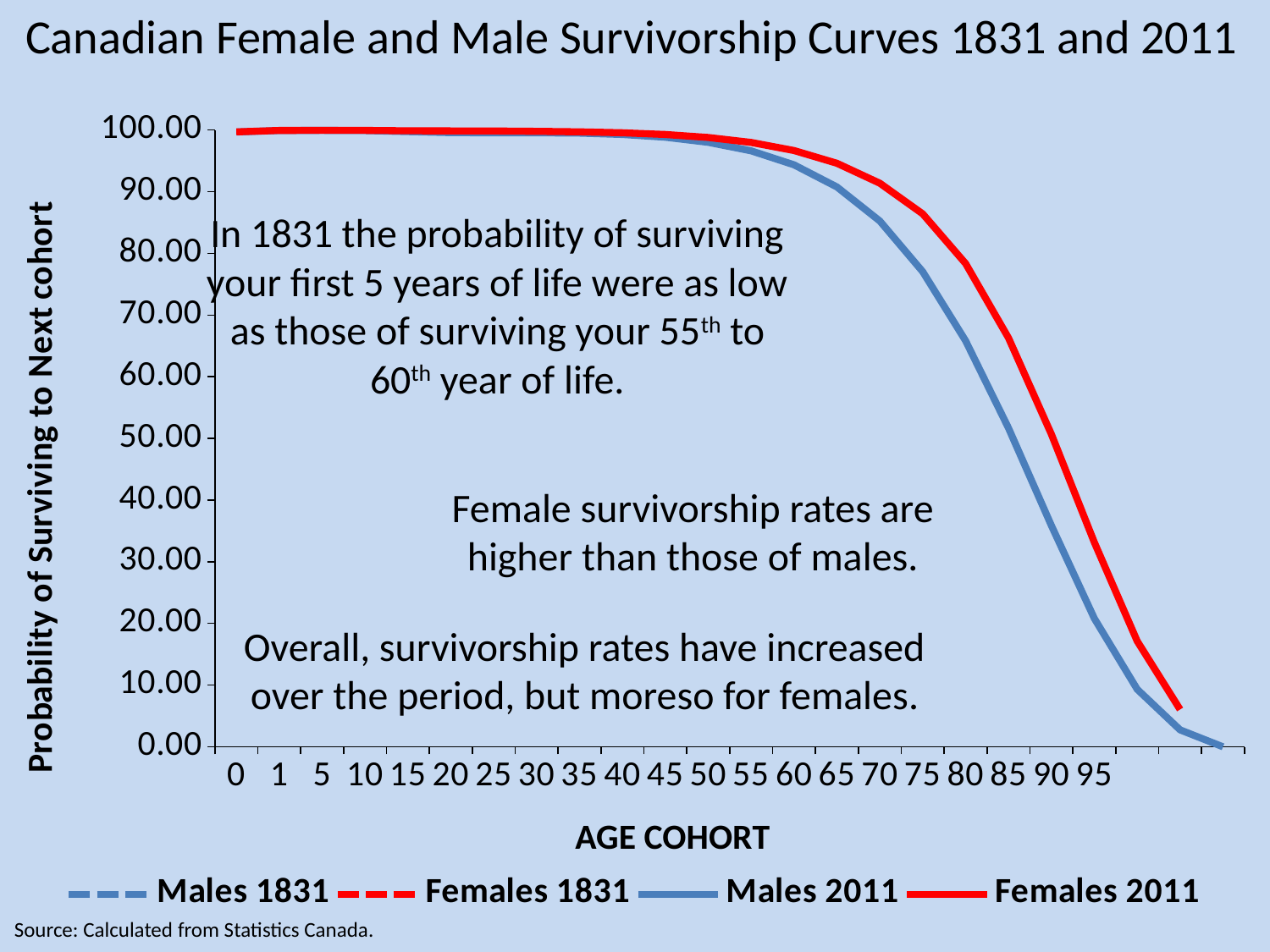
What is the title of the chart? Canadian Female and Male Survivorship Curves 1831 and 2011 Is the value for Females 2011 at age cohort 95 greater or less than 50.00? less At age cohort 85, which series has the higher value, Females 2011 or Males 2011? Females 2011 Is the value for Males 2011 at age cohort 60 greater or less than 90.00? greater What is the label of the x axis? AGE COHORT How many series does the legend list? 4 What kind of chart is shown on the slide? line chart Is the value for Males 2011 at age cohort 70 greater or less than 70.00? greater Do the survivorship values for Males 2011 rise or fall as the age cohort increases along the x axis? fall At age cohort 95, which series has the lower value, Females 2011 or Males 2011? Males 2011